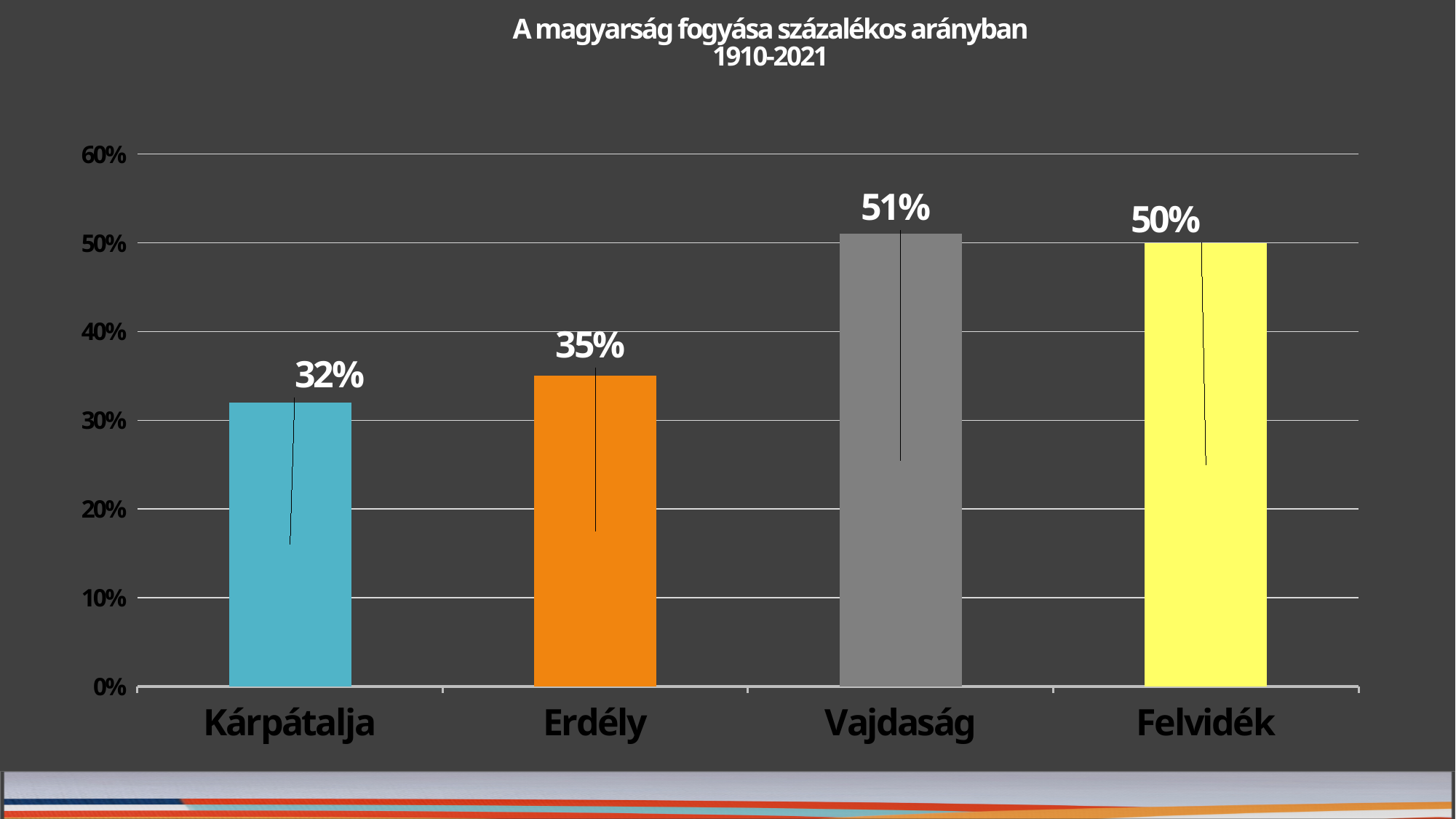
What is the difference between the values for Vajdaság and Kárpátalja? 19% Which is larger, the value for Erdély or the value for Felvidék? Felvidék Which category has the highest value? Vajdaság Which category has the lowest value? Kárpátalja What is the title of the chart? A magyarság fogyása százalékos arányban 1910-2021 How many categories are shown on the x axis? 4 What is the value for Vajdaság? 51% What is the difference between the values for Erdély and Kárpátalja? 3% What kind of chart is shown on the slide? Bar chart What is the value for Felvidék? 50% What is the value for Kárpátalja? 32% What is the value for Erdély? 35%